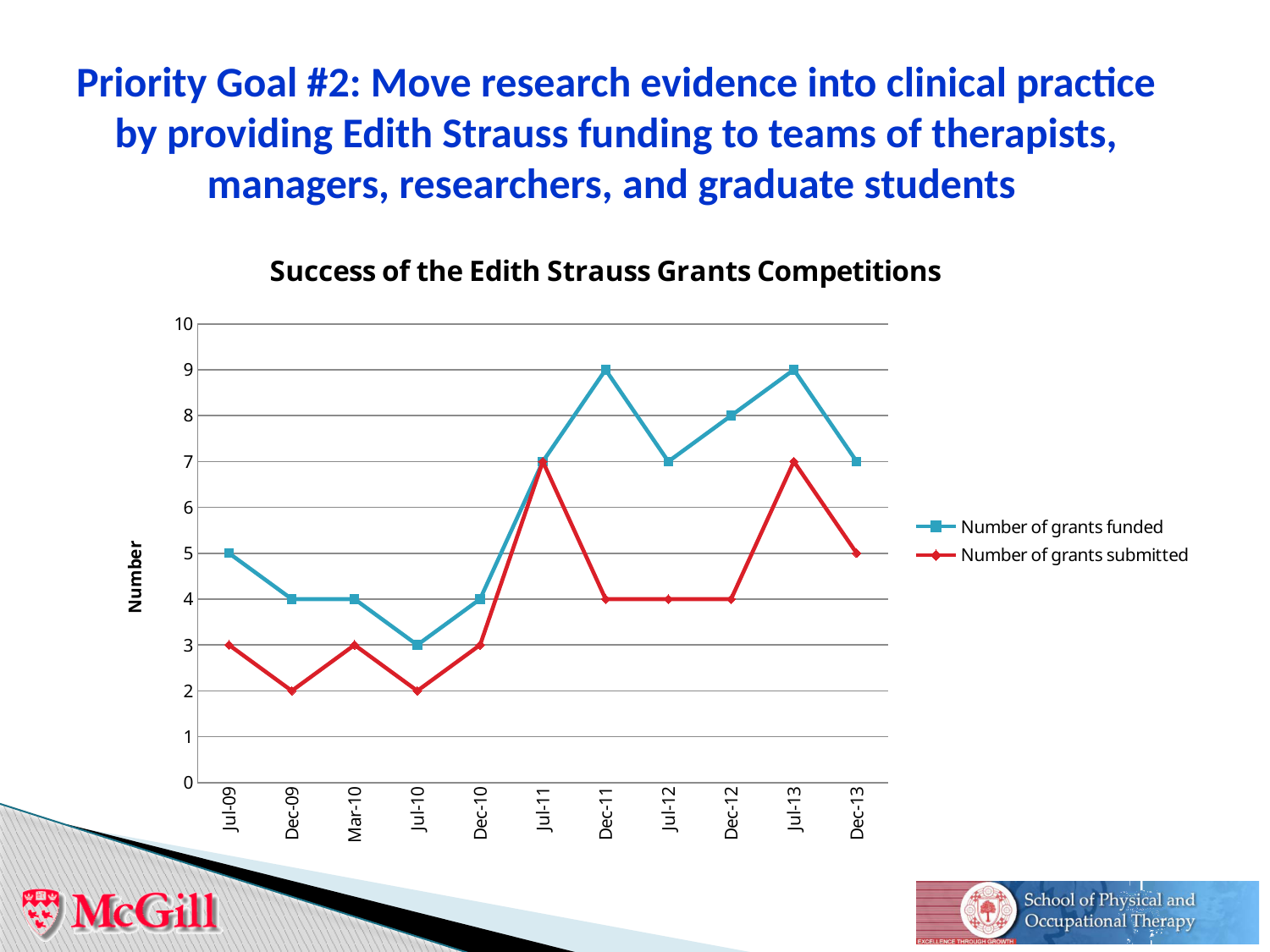
What is the number of grants submitted in Jul-11? 7 Does the number of grants funded rise or fall from Jul-10 to Dec-11? Rise What is the difference between the number of grants funded and the number of grants submitted in Dec-11? 5 What is the title of the chart? Success of the Edith Strauss Grants Competitions Which is larger in Dec-12: the number of grants funded or the number of grants submitted? Number of grants funded What kind of chart is shown on the slide? Line chart How many dates are plotted on the x axis? 11 What is the number of grants funded in Dec-11? 9 How many series does the legend list? 2 At which date is the number of grants funded lowest? Jul-10 What is the number of grants funded in Jul-10? 3 What is the number of grants submitted in Dec-13? 5